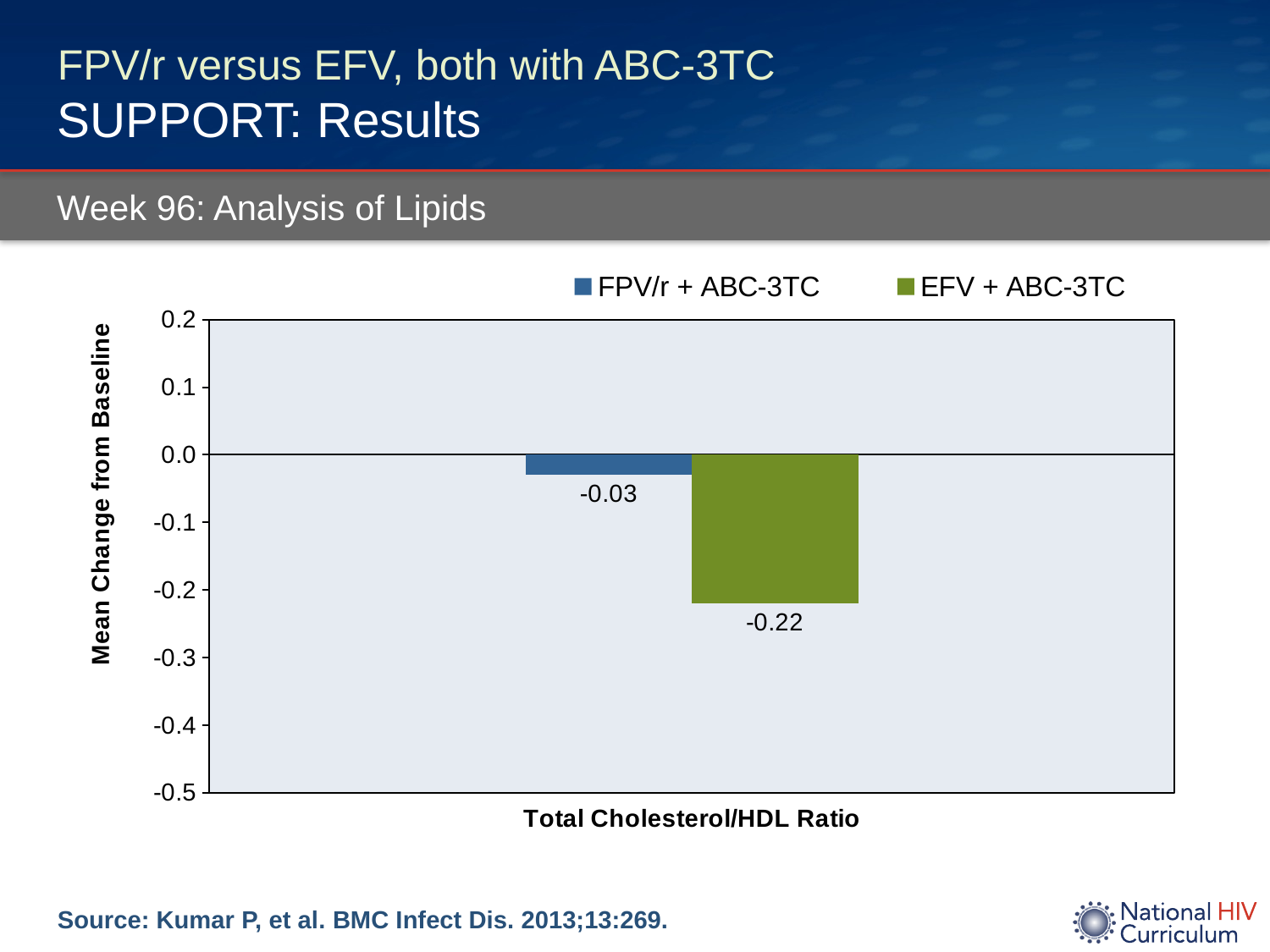
How many series does the legend list? 2 What is the category label on the x axis of the chart? Total Cholesterol/HDL Ratio What is the difference between the mean change for EFV + ABC-3TC and FPV/r + ABC-3TC? 0.19 Is the value for EFV + ABC-3TC greater or less than -0.2? less Which series has the lowest (most negative) mean change from baseline? EFV + ABC-3TC What is the label on the y axis of the chart? Mean Change from Baseline What kind of chart is shown on the slide? Bar chart What is the mean change from baseline in Total Cholesterol/HDL Ratio for EFV + ABC-3TC? -0.22 Which series has the highest mean change from baseline? FPV/r + ABC-3TC What is the mean change from baseline in Total Cholesterol/HDL Ratio for FPV/r + ABC-3TC? -0.03 Is the value for FPV/r + ABC-3TC greater or less than -0.1? greater Which series shows the larger decrease in Total Cholesterol/HDL Ratio from baseline? EFV + ABC-3TC